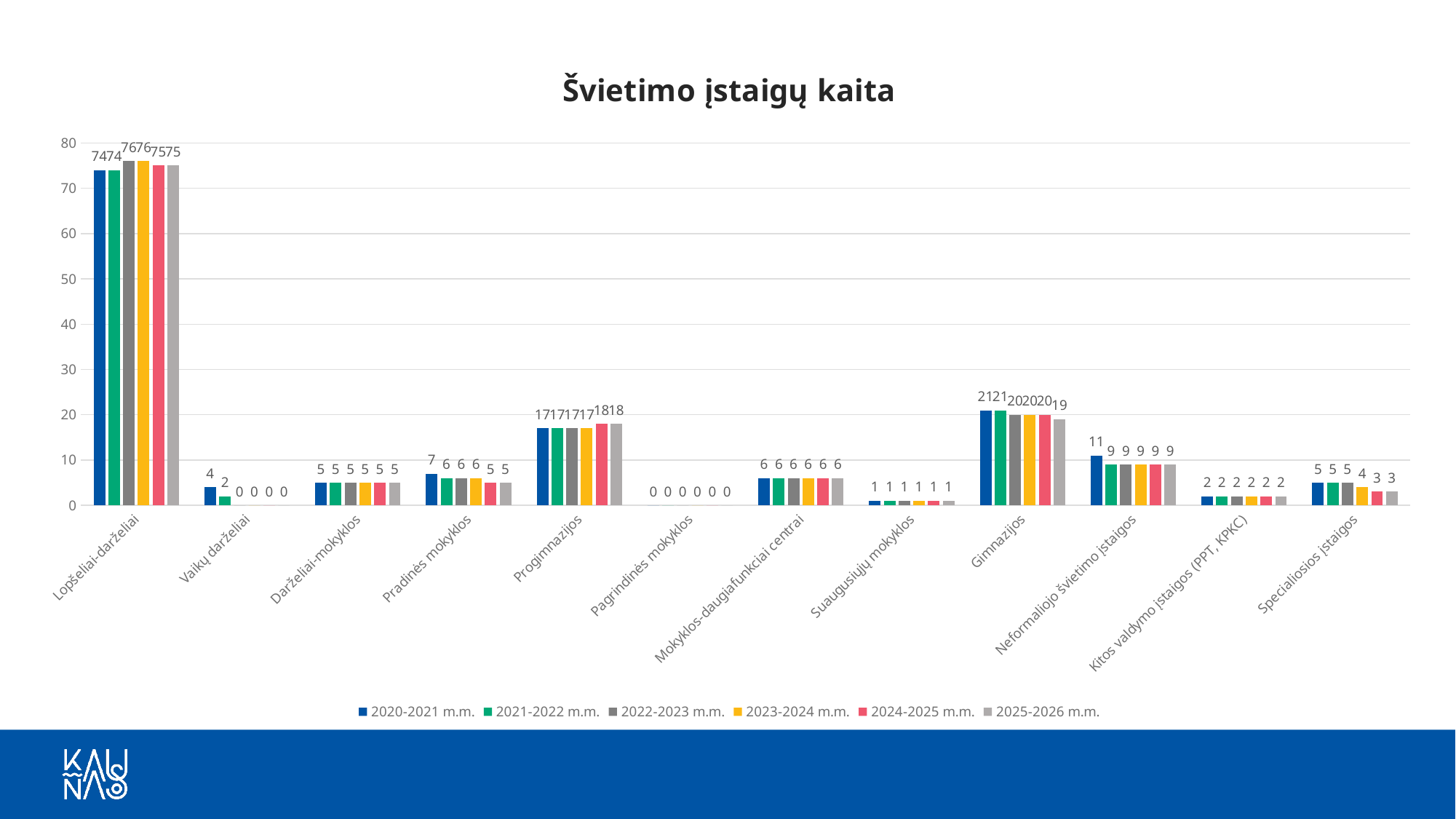
What is the value for Neformaliojo švietimo įstaigos in the 2020-2021 m.m. series? 11 What is the value for Gimnazijos in the 2025-2026 m.m. series? 19 Which category has the highest values across all series? Lopšeliai-darželiai What is the title of the chart? Švietimo įstaigų kaita Do the values for Vaikų darželiai rise or fall from the 2020-2021 m.m. series to the 2025-2026 m.m. series? fall Which is larger for Progimnazijos: the 2020-2021 m.m. value or the 2024-2025 m.m. value? 2024-2025 m.m. Which category has a value of 0 in every series? Pagrindinės mokyklos How many series does the legend list? 6 What is the difference between the 2020-2021 m.m. and 2025-2026 m.m. values for Specialiosios įstaigos? 2 What type of chart is shown on the slide? bar chart How many categories are shown on the x axis? 12 What is the value for Lopšeliai-darželiai in the 2022-2023 m.m. series? 76